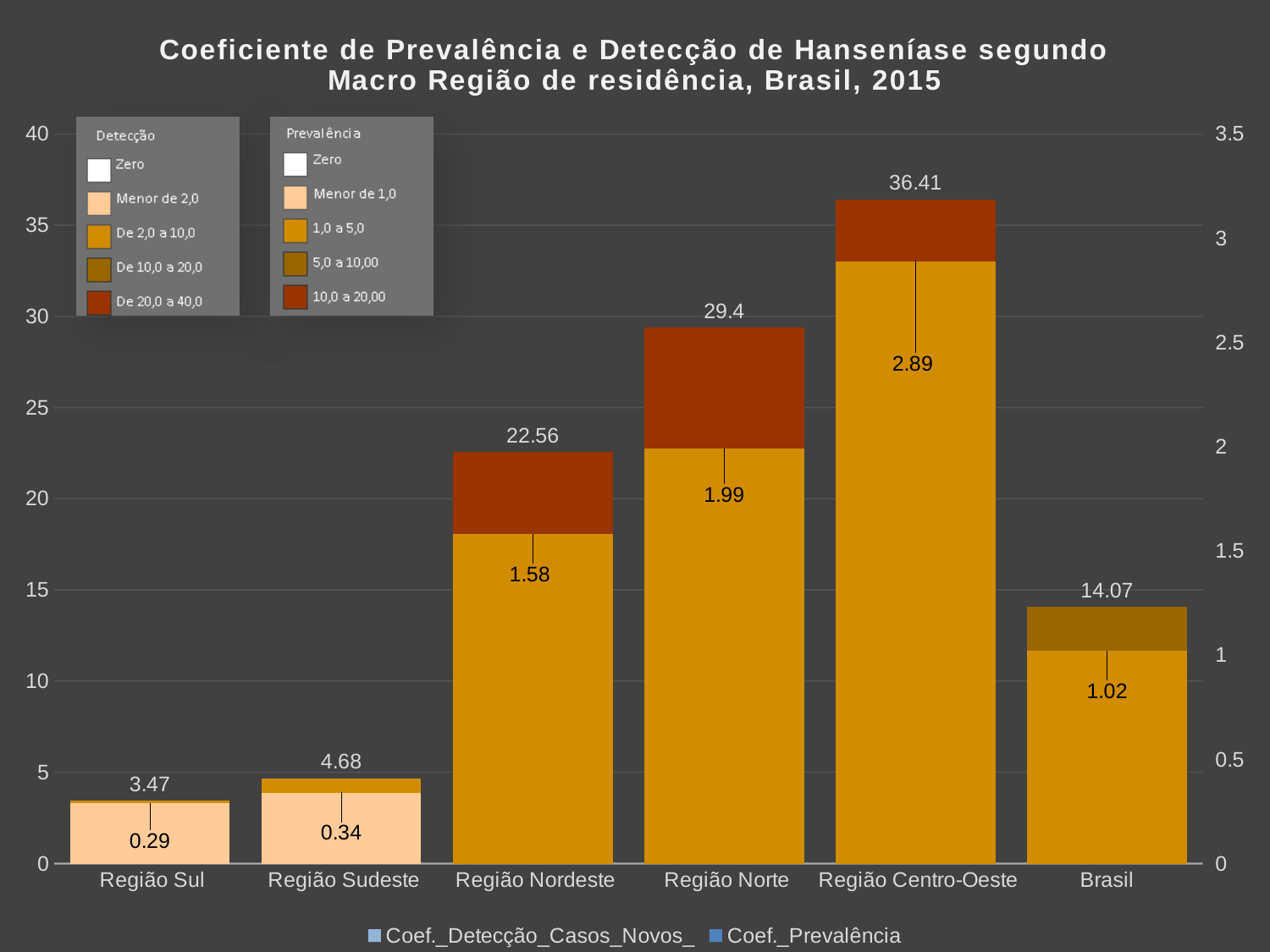
What is the title of the chart? Coeficiente de Prevalência e Detecção de Hanseníase segundo Macro Região de residência, Brasil, 2015 Which region has the highest Coef._Detecção_Casos_Novos_ value? Região Centro-Oeste What is the Coef._Prevalência value for Região Centro-Oeste? 2.89 Which category has the lowest Coef._Prevalência value? Região Sul What is the Coef._Detecção_Casos_Novos_ value for Região Norte? 29.4 How many series does the legend at the bottom of the chart list? 2 Which is larger, the Coef._Detecção_Casos_Novos_ value for Região Nordeste or for Brasil? Região Nordeste What kind of chart is shown on the slide? bar chart What is the difference between the Coef._Detecção_Casos_Novos_ values for Região Centro-Oeste and Região Norte? 7.01 What is the Coef._Prevalência value for Brasil? 1.02 How many categories are shown on the x axis? 6 Is the Coef._Detecção_Casos_Novos_ value for Região Nordeste greater or less than 20? greater